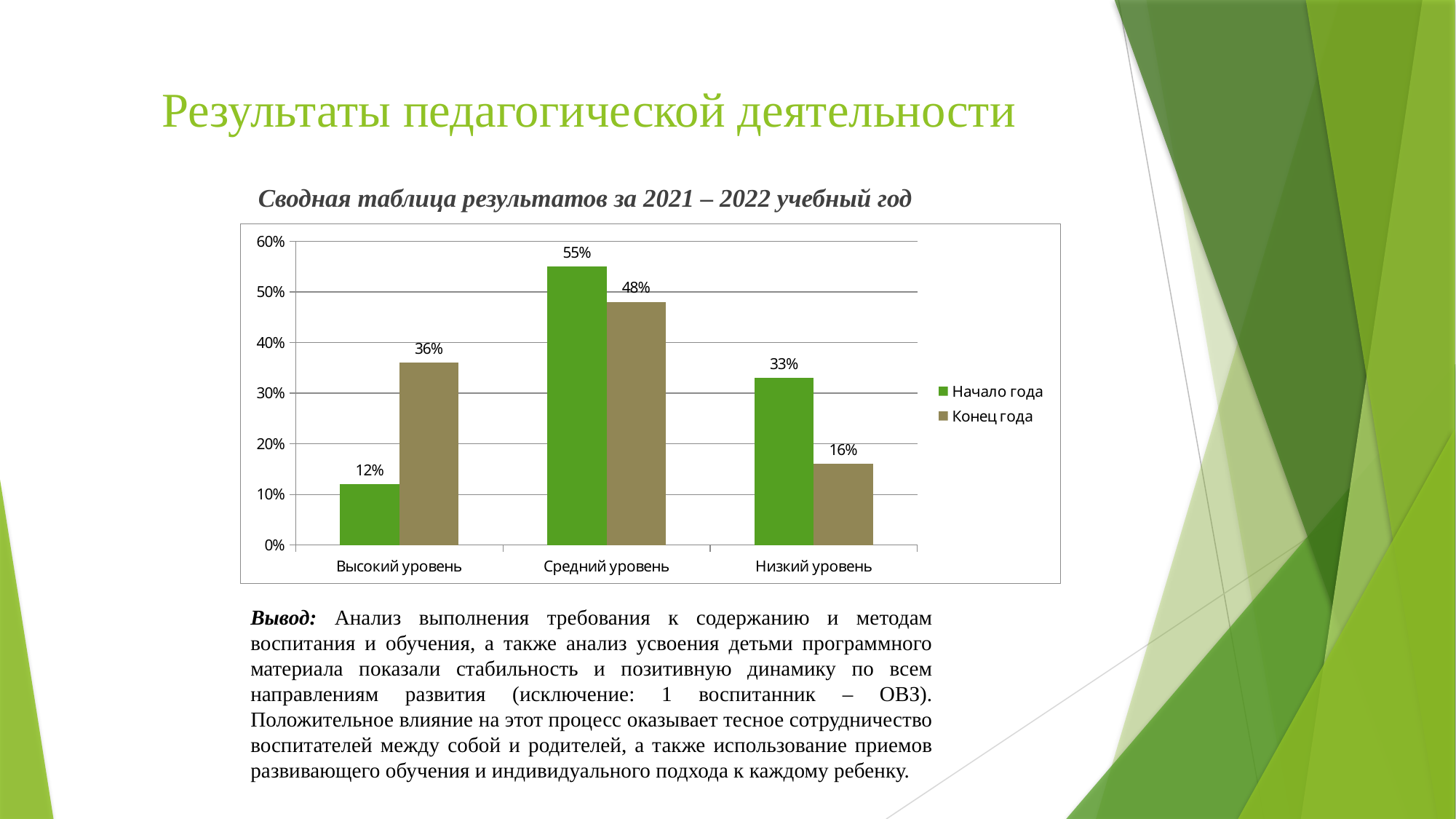
What is the value for Высокий уровень in the Начало года series? 12% What is the title above the chart? Сводная таблица результатов за 2021 – 2022 учебный год Which category has the lowest value in the Конец года series? Низкий уровень What is the value for Низкий уровень in the Конец года series? 16% What is the difference between the Начало года and Конец года values for Низкий уровень? 17% Which is larger for Средний уровень: the Начало года value or the Конец года value? Начало года What is the difference between the Начало года and Конец года values for Высокий уровень? 24% What kind of chart is shown on the slide? Bar chart Which category has the highest value in the Начало года series? Средний уровень How many categories are shown on the x axis? 3 What is the value for Средний уровень in the Конец года series? 48% How many series does the legend list? 2